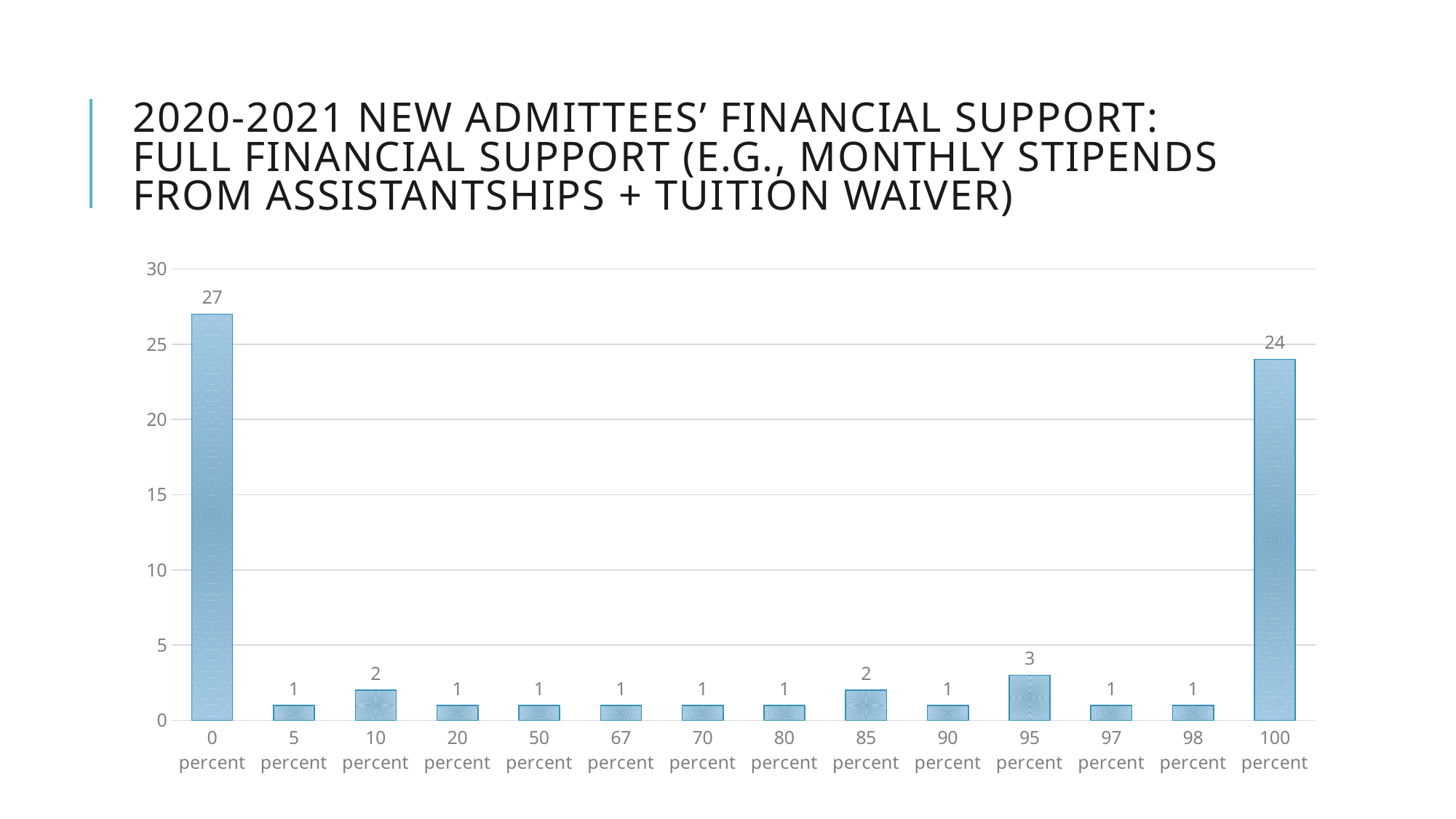
Is the value for 100 percent greater or less than 20? greater What is the value for the 0 percent category? 27 What kind of chart is shown on the slide? bar chart What is the difference between the values for 95 percent and 90 percent? 2 Which is larger, the value for 10 percent or the value for 95 percent? 95 percent What is the value for the 85 percent category? 2 What is the difference between the values for 0 percent and 100 percent? 3 Which category has the highest value? 0 percent What is the value for the 95 percent category? 3 How many categories are shown on the x axis? 14 What is the highest value shown on the vertical axis? 30 What is the value for the 100 percent category? 24